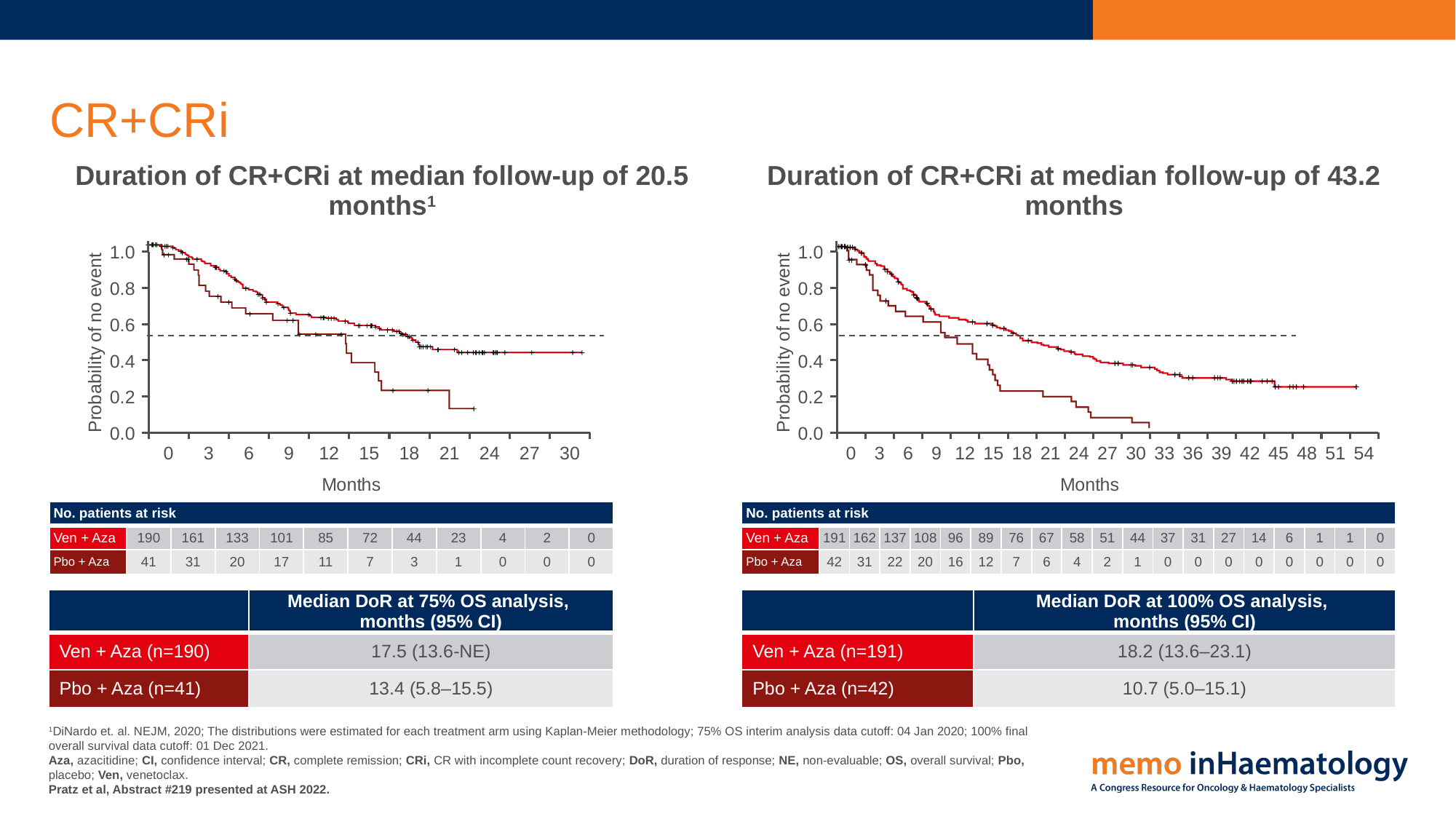
In the left chart (median follow-up of 20.5 months), what is the difference in the number of Ven + Aza patients at risk between month 0 and month 3? 29 In the left chart (median follow-up of 20.5 months), what is the median DoR for Ven + Aza at the 75% OS analysis? 17.5 (13.6-NE) In the left chart (median follow-up of 20.5 months), is the probability of no event for the Pbo + Aza curve at month 18 greater or less than 0.4? less In the right chart (median follow-up of 43.2 months), how many patients in the Pbo + Aza arm were at risk at month 30? 1 What kind of chart is shown under the title 'Duration of CR+CRi at median follow-up of 20.5 months'? Line chart (Kaplan-Meier curve) In the right chart (median follow-up of 43.2 months), what is the median DoR for Pbo + Aza at the 100% OS analysis? 10.7 (5.0–15.1) In the left chart (median follow-up of 20.5 months), how many patients in the Pbo + Aza arm were at risk at month 12? 11 In the right chart (median follow-up of 43.2 months), which arm has the higher median DoR at the 100% OS analysis, Ven + Aza or Pbo + Aza? Ven + Aza How many treatment arms are plotted in each Kaplan-Meier chart on the slide? 2 In the left chart (median follow-up of 20.5 months), how many patients in the Ven + Aza arm were at risk at month 0? 190 In the right chart (median follow-up of 43.2 months), is the probability of no event for the Ven + Aza curve at month 48 greater or less than 0.4? less In the right chart (median follow-up of 43.2 months), how many patients in the Ven + Aza arm were at risk at month 24? 58